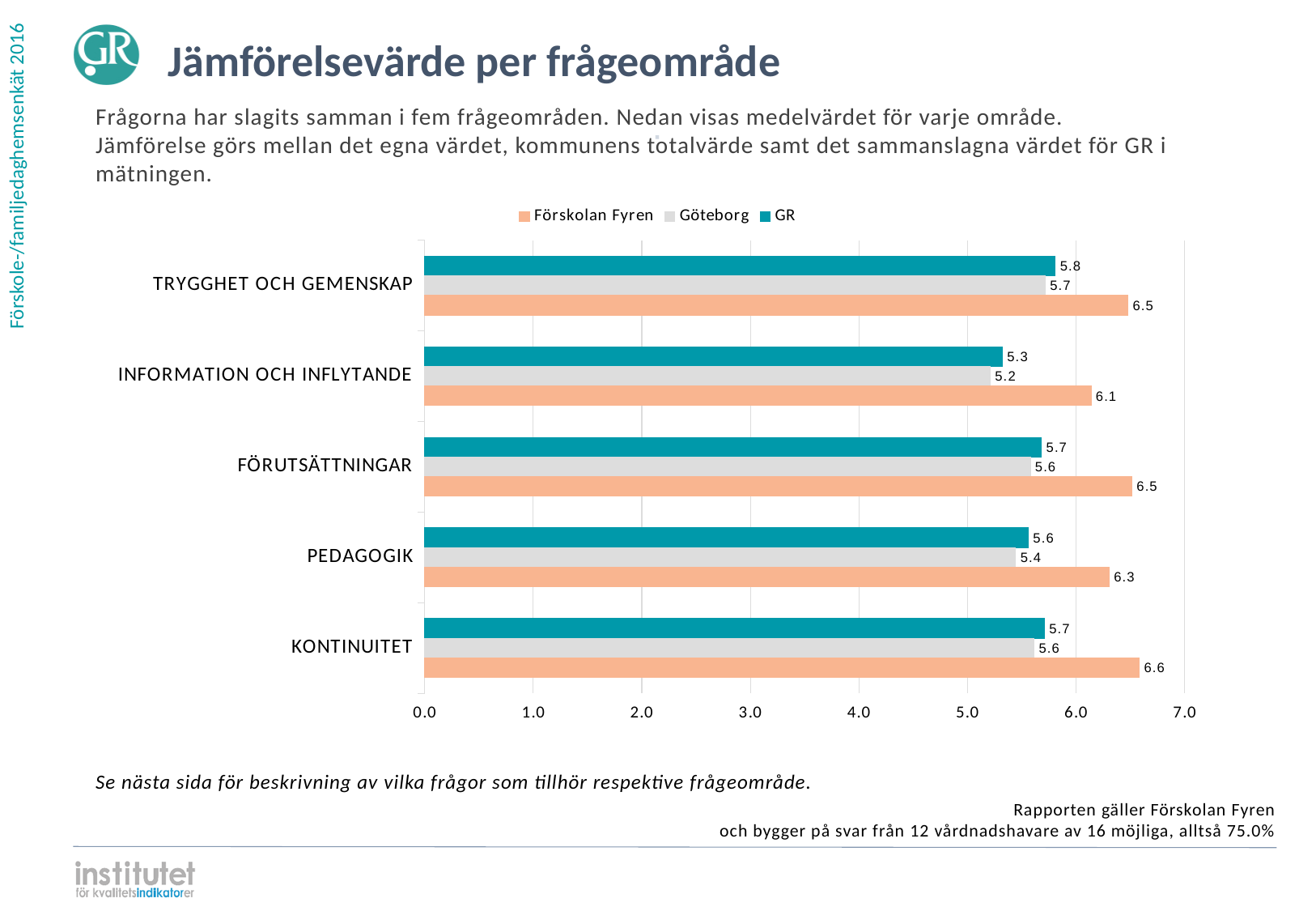
How many categories are shown on the chart? 5 What is the value for Förskolan Fyren in the TRYGGHET OCH GEMENSKAP category? 6.5 Which series is shown in orange in the legend? Förskolan Fyren Which is larger in the FÖRUTSÄTTNINGAR category: the value for Förskolan Fyren or the value for GR? Förskolan Fyren Is the value for Förskolan Fyren in the INFORMATION OCH INFLYTANDE category greater or less than 6.0? greater What is the value for GR in the PEDAGOGIK category? 5.6 Which category has the lowest value for GR? INFORMATION OCH INFLYTANDE Which category has the highest value for Förskolan Fyren? KONTINUITET How many series does the legend list? 3 What is the difference between the Förskolan Fyren value and the Göteborg value in the PEDAGOGIK category? 0.9 What is the value for Göteborg in the INFORMATION OCH INFLYTANDE category? 5.2 What kind of chart is shown on the slide? bar chart